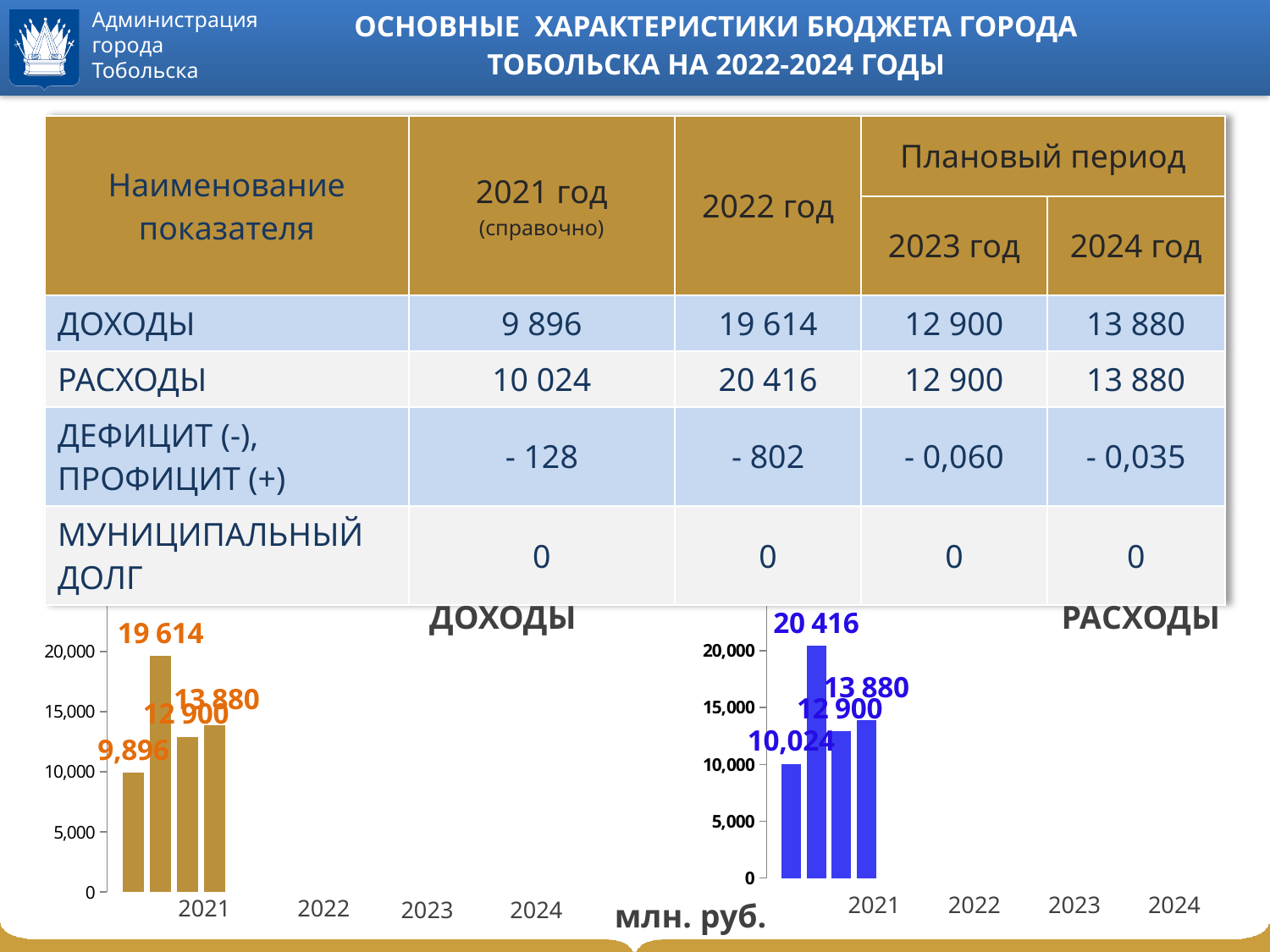
On the РАСХОДЫ chart, which year has the lowest value? 2021 On the РАСХОДЫ chart, what is the value labelled on the first (2021) bar? 10,024 On the ДОХОДЫ chart, what is the difference between the 2024 value (13 880) and the 2023 value (12 900)? 980 How many bars are shown on the РАСХОДЫ chart? 4 On the ДОХОДЫ chart, what is the value labelled on the tallest bar? 19 614 On the ДОХОДЫ chart, is the 2021 value greater or less than 10,000? less What colour are the bars on the РАСХОДЫ chart? Blue On the РАСХОДЫ chart, is the 2022 value greater or less than 20,000? greater What type of chart is the ДОХОДЫ chart? Bar chart On the РАСХОДЫ chart, what is the value labelled on the tallest bar? 20 416 On the ДОХОДЫ chart, what is the value labelled on the first (2021) bar? 9,896 On the ДОХОДЫ chart, which year has the highest value? 2022